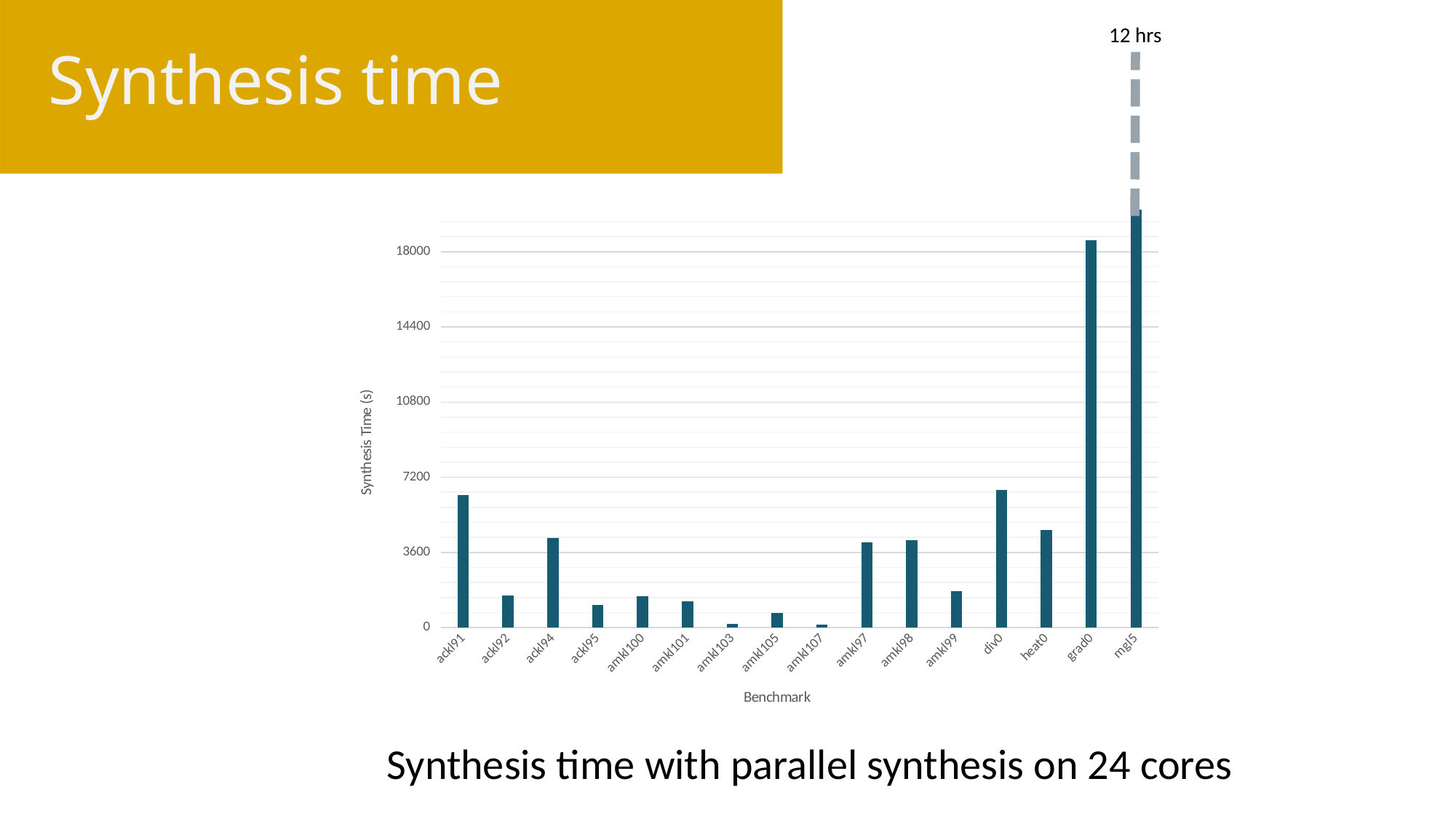
What kind of chart is shown on the slide? bar chart Which has a larger synthesis time, ackl91 or heat0? ackl91 Is the synthesis time for ackl91 greater or less than 7200? less Is the synthesis time for grad0 greater or less than 18000? greater How many benchmarks are plotted on the x axis of the chart? 16 Which has a larger synthesis time, grad0 or mgl5? mgl5 Is the synthesis time for amkl99 greater or less than 3600? less What is the label of the y axis of the chart? Synthesis Time (s) What label is shown above the dashed vertical line at the right of the chart? 12 hrs Which benchmark has the highest synthesis time? mgl5